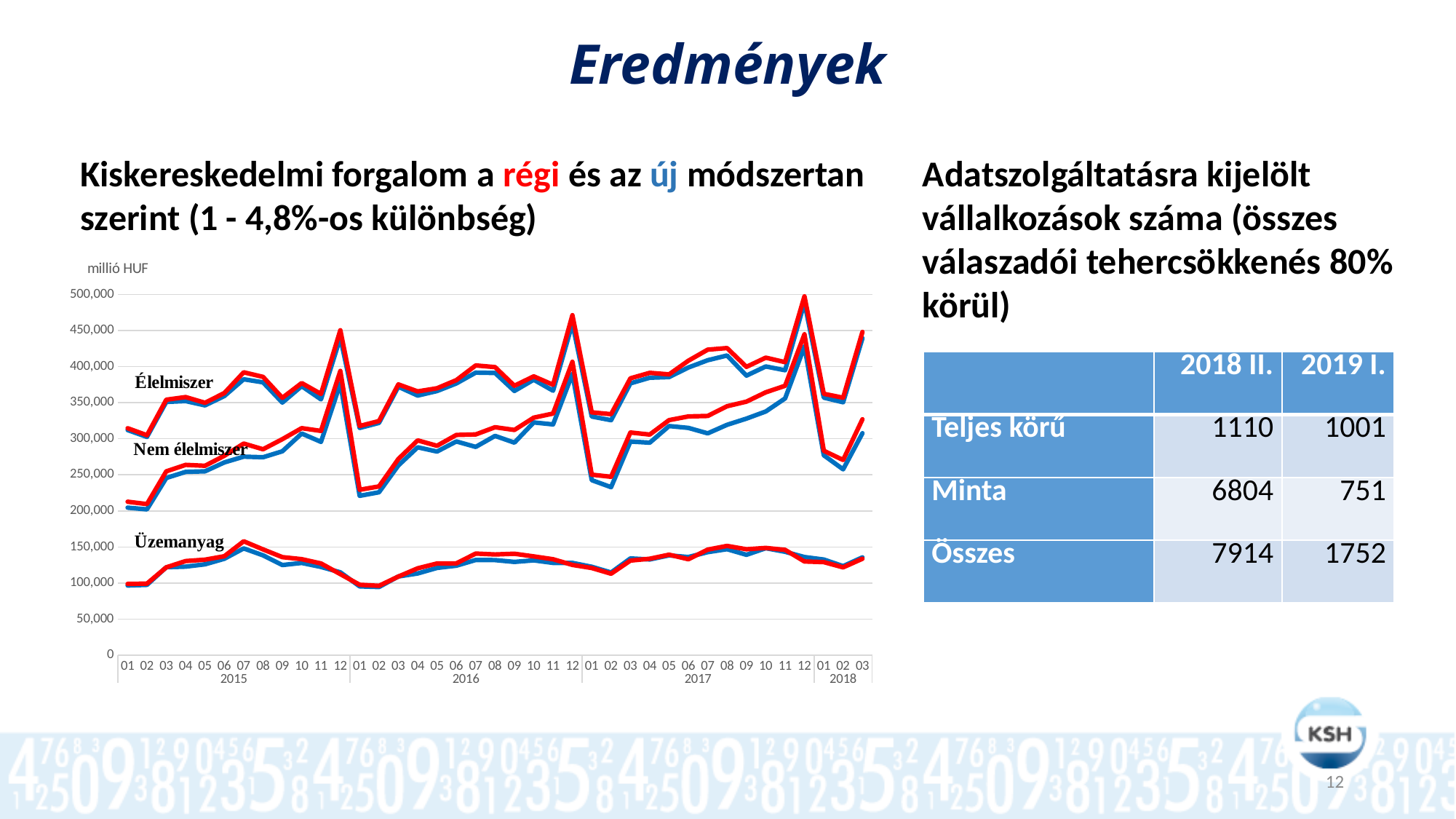
In which month of 2017 does Élelmiszer reach its highest value? 12 Is the value for Nem élelmiszer in 01 2016 greater or less than 250,000? less Is the value for Élelmiszer in 12 2017 greater or less than 400,000? greater How many years are labelled on the horizontal axis of the chart? 4 Is the value for Üzemanyag in 12 2017 greater or less than 200,000? less What kind of chart is shown on the slide? line chart Which of the three labelled groups in the chart has the lowest values throughout the period? Üzemanyag Which of the three labelled groups in the chart has the highest values throughout the period? Élelmiszer What unit is shown above the vertical axis of the chart? millió HUF How many months of 2018 are plotted in the chart? 3 Which colour represents the old (régi) methodology in the chart? red